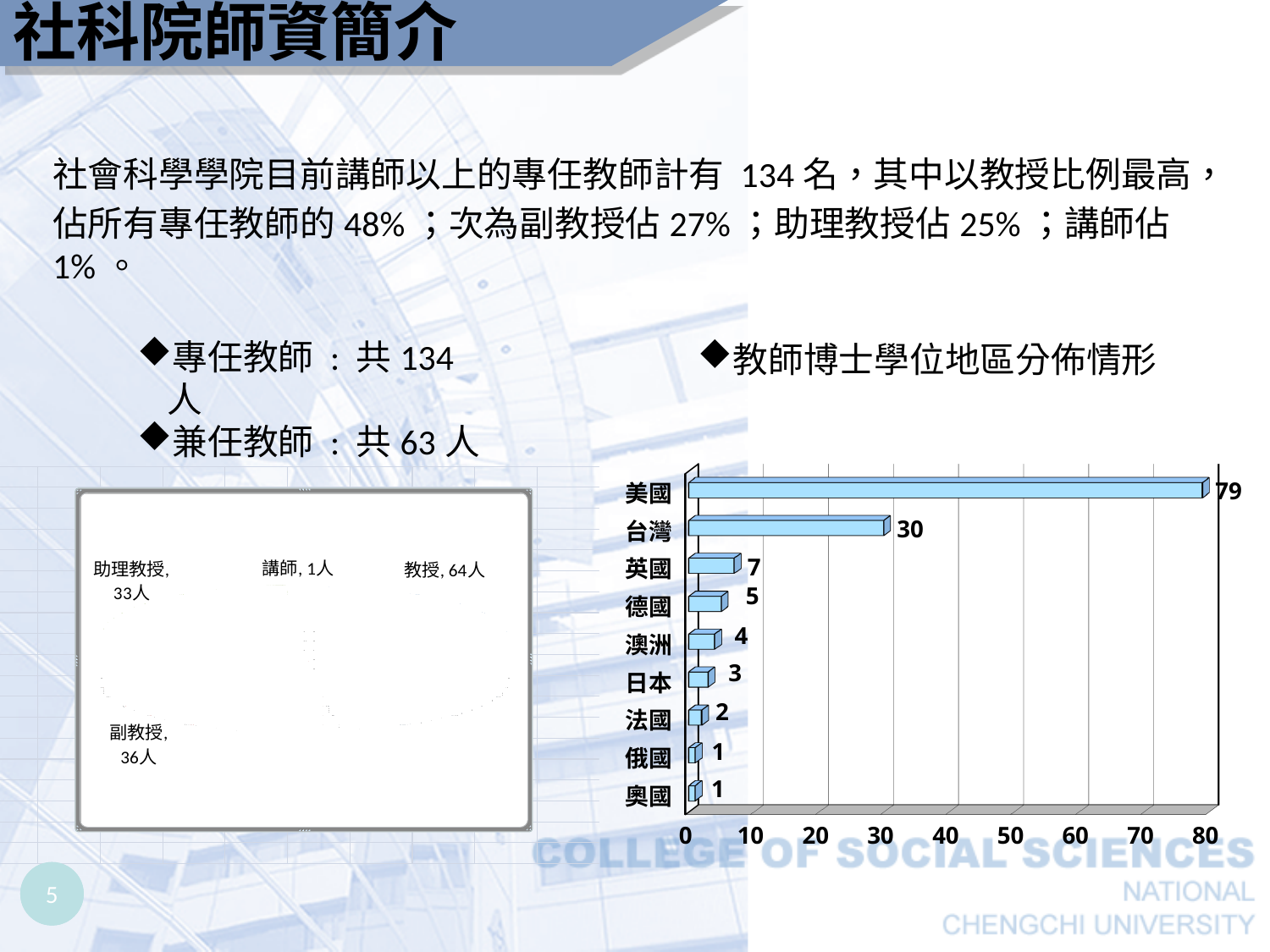
In the bar chart titled 教師博士學位地區分佈情形, what is the highest value shown on the horizontal axis? 80 In the pie chart on the left of the slide, what is the value for 教授? 64人 In the bar chart titled 教師博士學位地區分佈情形, how many regions are shown? 9 In the bar chart titled 教師博士學位地區分佈情形, which has a larger value, 英國 or 澳洲? 英國 In the bar chart titled 教師博士學位地區分佈情形, what is the difference between the values for 美國 and 台灣? 49 What kind of chart is the chart titled 教師博士學位地區分佈情形? bar chart In the bar chart titled 教師博士學位地區分佈情形, what is the value for 台灣? 30 In the pie chart on the left of the slide, what is the value for 副教授? 36人 In the bar chart titled 教師博士學位地區分佈情形, which region has the highest value? 美國 In the pie chart on the left of the slide, what is the difference between the values for 副教授 and 助理教授? 3人 In the bar chart titled 教師博士學位地區分佈情形, what is the value for 美國? 79 In the bar chart titled 教師博士學位地區分佈情形, what is the value for 德國? 5